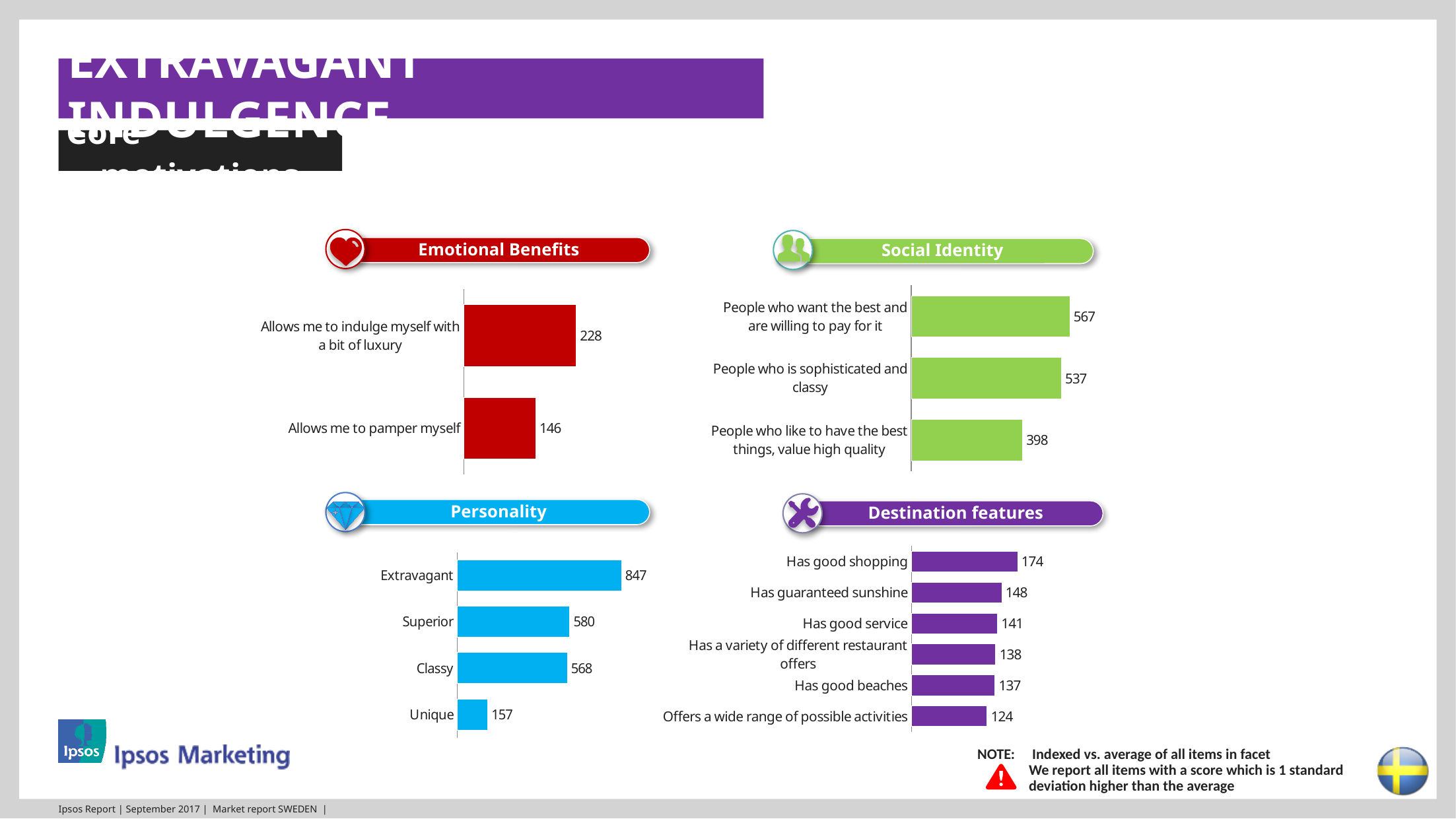
In the Social Identity chart, how many categories are shown? 3 In the Emotional Benefits chart, what is the difference between the two bars? 82 In the Personality chart, which category has the lowest value? Unique In the Destination features chart, how many categories are shown? 6 In the Emotional Benefits chart, what is the value for "Allows me to indulge myself with a bit of luxury"? 228 In the Destination features chart, which is larger: "Has good shopping" or "Offers a wide range of possible activities"? Has good shopping In the Social Identity chart, what is the value for "People who like to have the best things, value high quality"? 398 In the Social Identity chart, which category has the highest value? People who want the best and are willing to pay for it In the Destination features chart, what is the value for "Has guaranteed sunshine"? 148 In the Personality chart, what is the difference between "Extravagant" and "Classy"? 279 In the Personality chart, what is the value for "Superior"? 580 What type of chart is the Personality chart? Bar chart